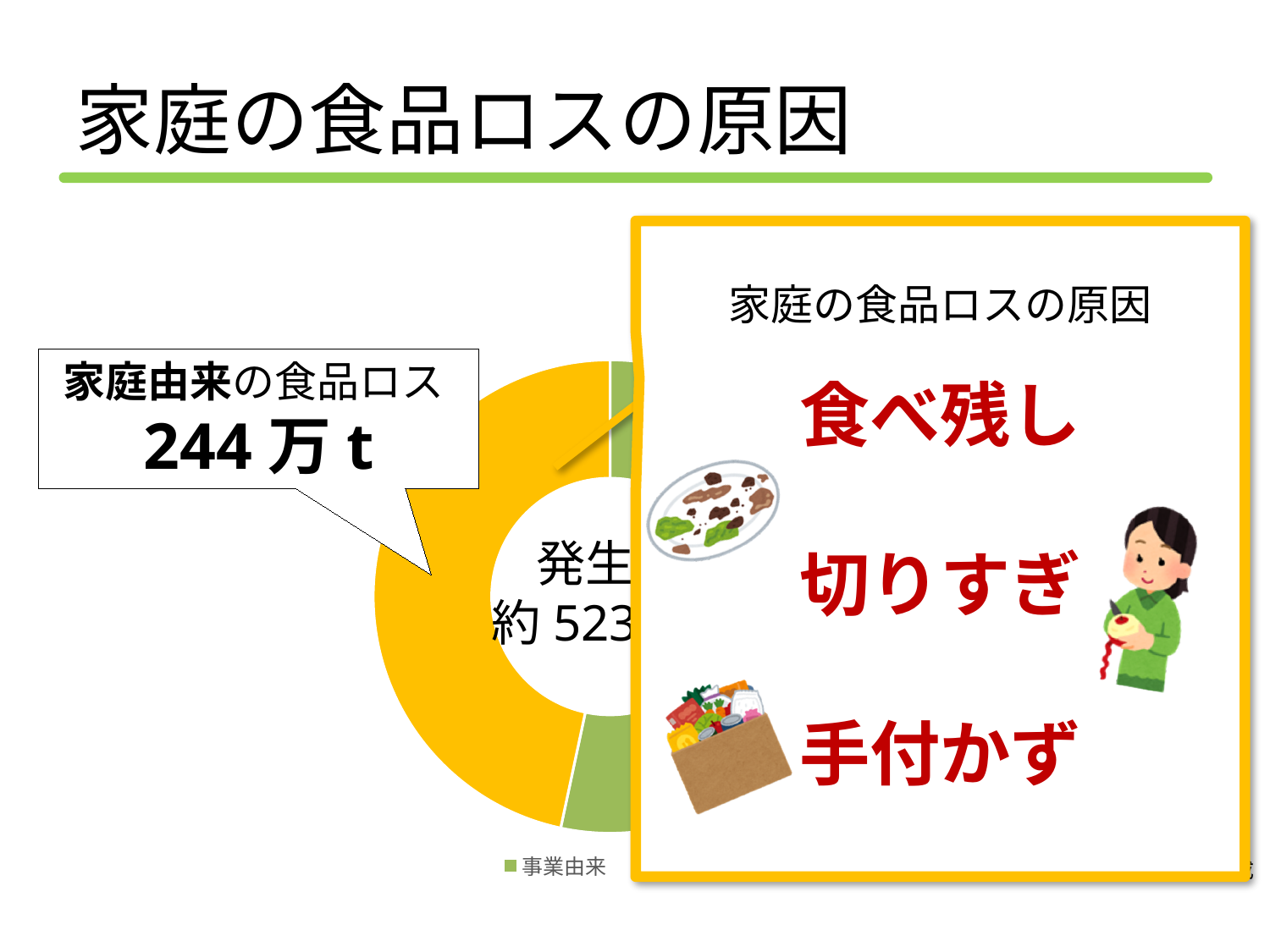
Which colour represents 家庭由来 (household-origin) food loss in the chart? Yellow According to the callout on the chart, how much food loss comes from households (家庭由来)? 244万t Which category does the green segment of the chart represent, according to the legend? 事業由来 What kind of chart is shown on the slide? Doughnut (pie) chart